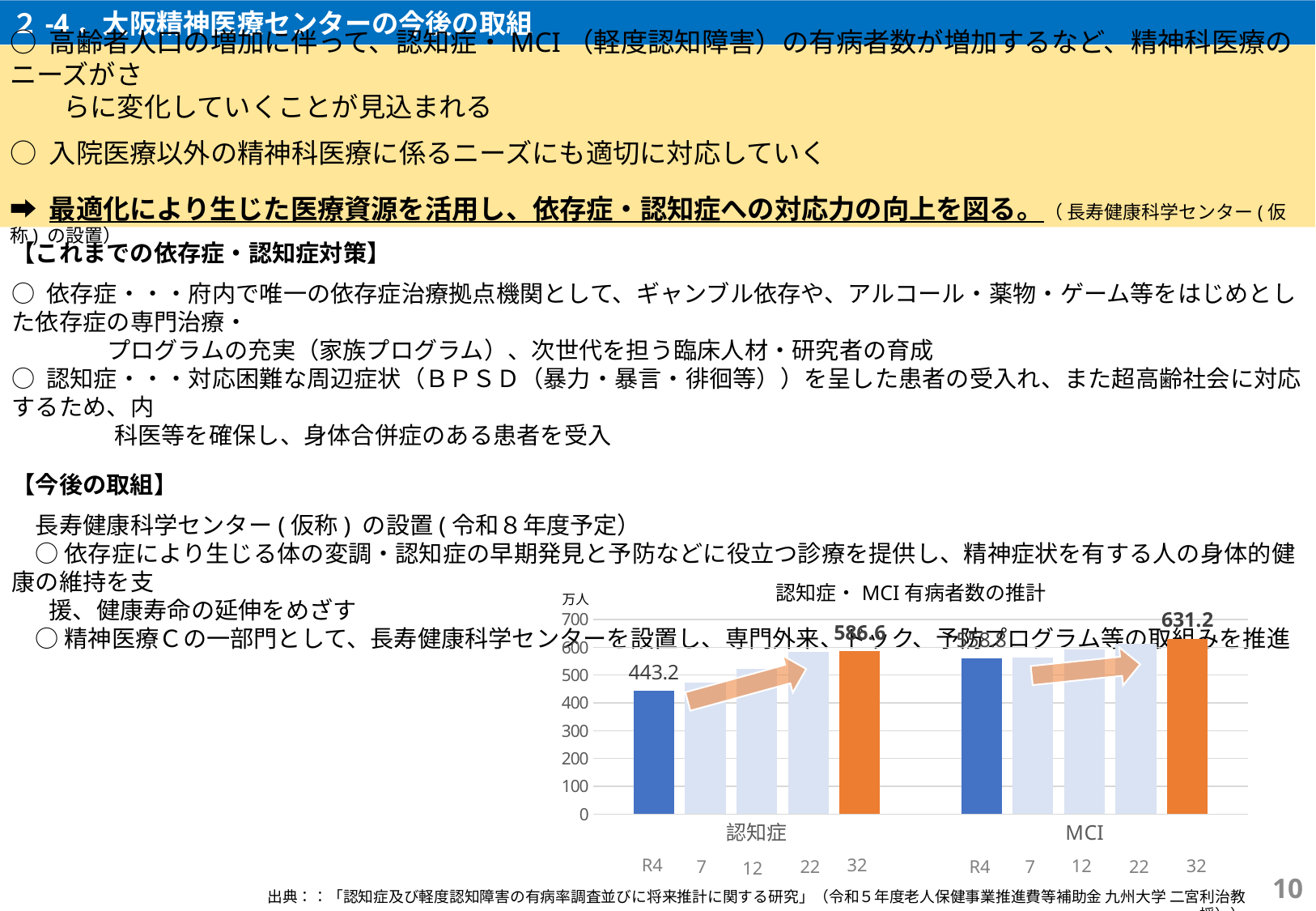
Is the value for 認知症 in R4 greater or less than 500? less What is the value for 認知症 in R4? 443.2 What is the value for 認知症 in 32? 586.6 Which is larger in 32: the value for 認知症 or the value for MCI? MCI What is the value for MCI in 32? 631.2 How many bars are shown for the MCI group? 5 Which bar has the highest value in the chart? MCI in 32 By how much does the 認知症 value in 32 exceed the 認知症 value in R4? 143.4 Do the values for 認知症 rise or fall from R4 to 32? rise What kind of chart is shown on the slide? bar chart Is the value for MCI in R4 greater or less than 500? greater What is the title of the chart? 認知症・MCI有病者数の推計